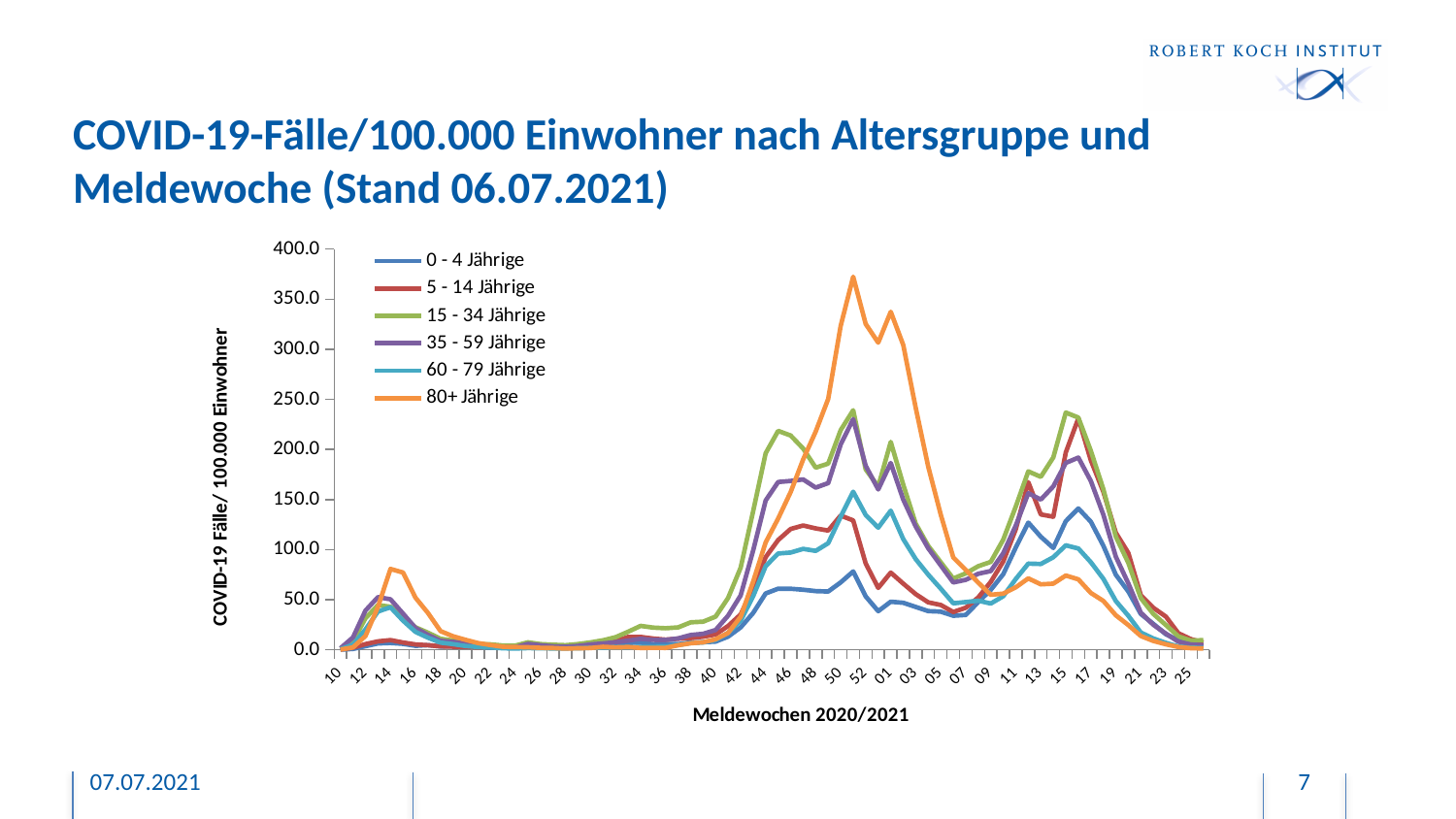
What is the title of the vertical axis? COVID-19 Fälle/ 100.000 Einwohner What colour is the line for 80+ Jährige? orange Is the peak value for 80+ Jährige around week 51 greater or less than 300? greater How many series does the legend list? 6 What kind of chart is shown on the slide? line chart Is the value for 15 - 34 Jährige at week 46 greater or less than 200? greater Is the peak value for 0 - 4 Jährige greater or less than 200? less At week 16 of 2021, which series has the larger value: 15 - 34 Jährige or 80+ Jährige? 15 - 34 Jährige Which age group reaches the highest peak value in the chart? 80+ Jährige At week 51, which series has the larger value: 80+ Jährige or 0 - 4 Jährige? 80+ Jährige Between week 40 and week 51 of 2020, do the values for 80+ Jährige rise or fall? rise